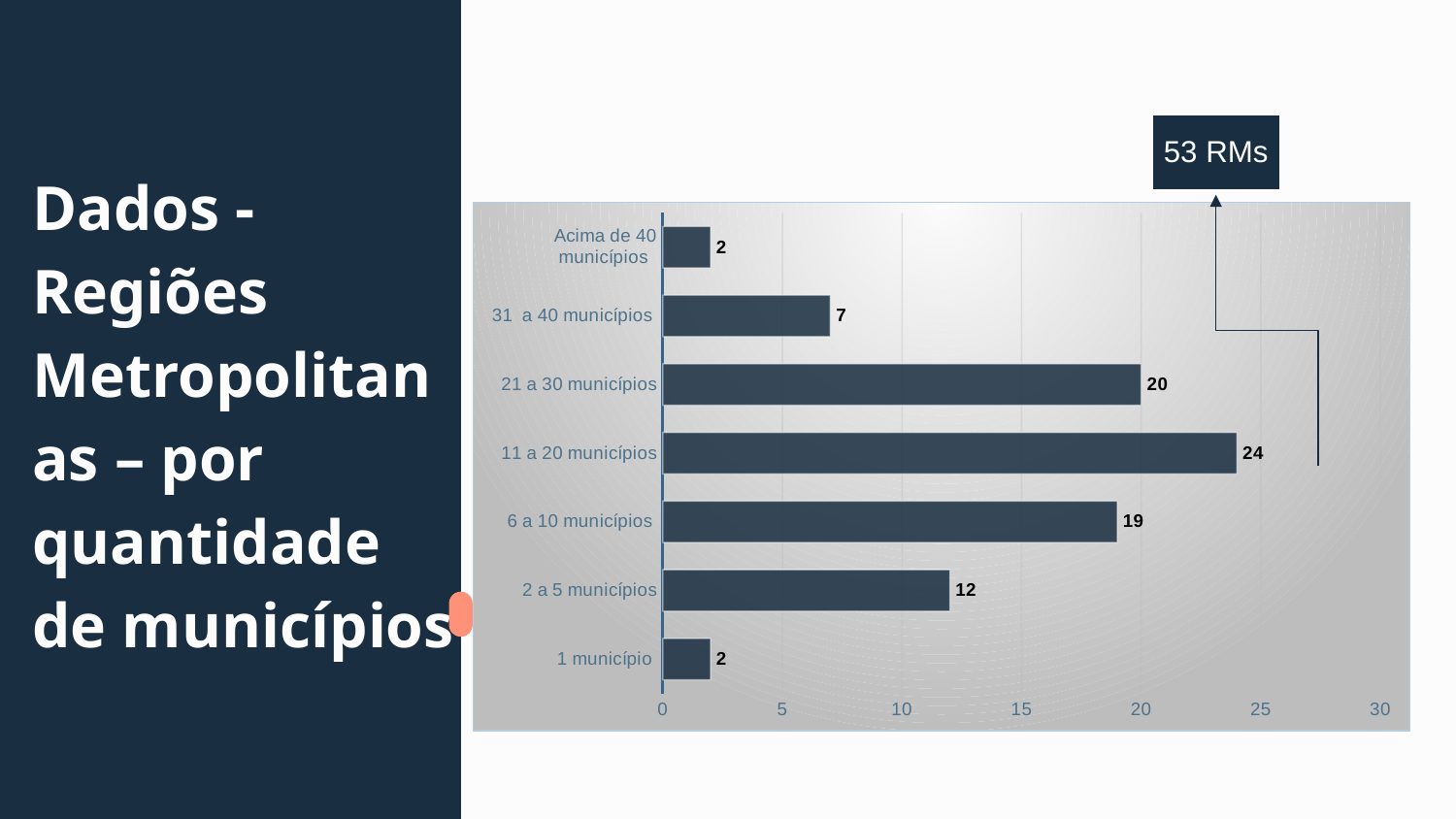
Is the value for "21 a 30 municípios" greater or less than 15? greater What does the label in the box above the chart say? 53 RMs What is the value for the category "1 município"? 2 Which category has the highest value? 11 a 20 municípios Which is larger, the value for "6 a 10 municípios" or the value for "2 a 5 municípios"? 6 a 10 municípios What is the value for the category "31 a 40 municípios"? 7 How many categories are shown on the chart? 7 What kind of chart is shown on the slide? bar chart What is the difference between the values for "21 a 30 municípios" and "6 a 10 municípios"? 1 What is the value for the category "2 a 5 municípios"? 12 What is the value for the category "11 a 20 municípios"? 24 What is the difference between the values for "11 a 20 municípios" and "Acima de 40 municípios"? 22